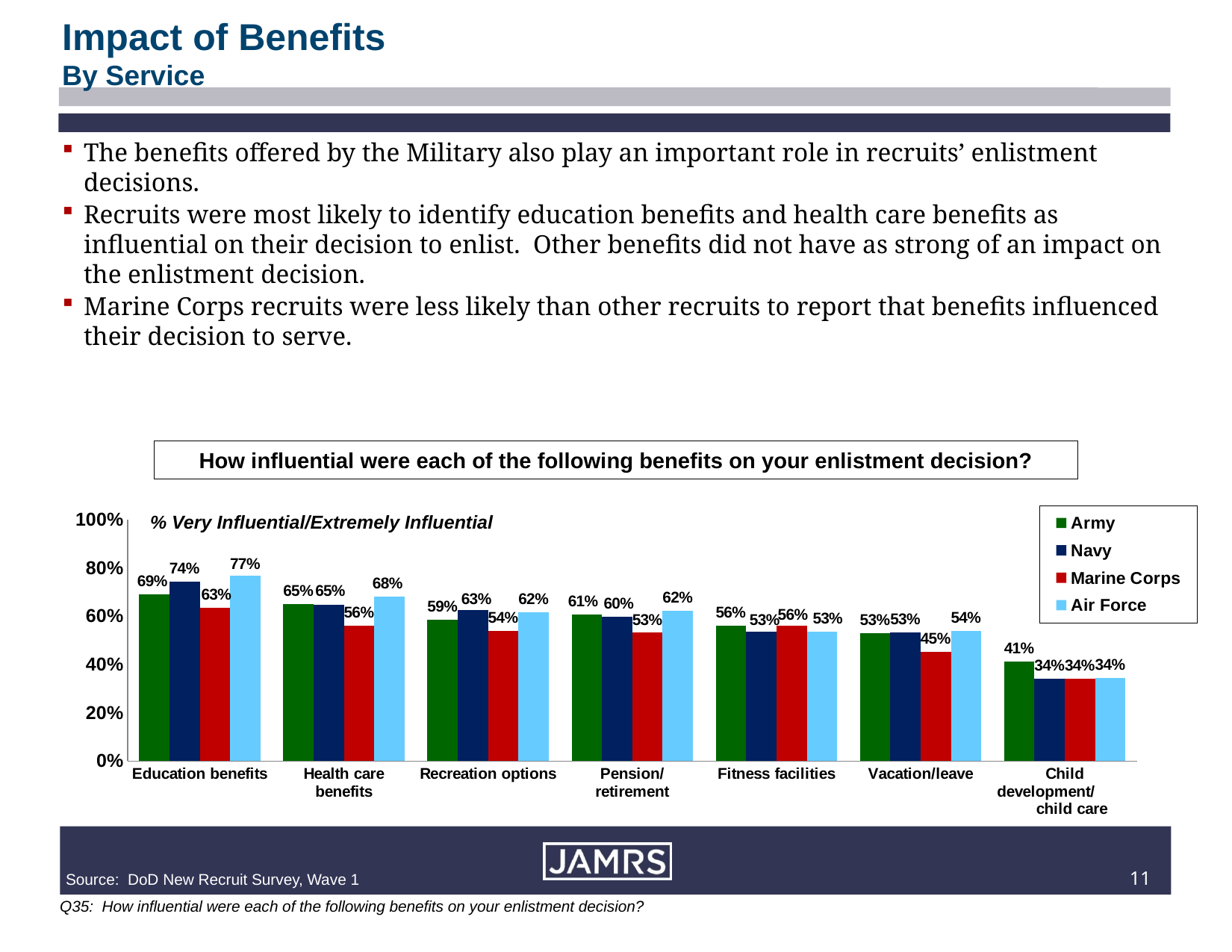
Which is larger for recreation options: the Navy value or the Army value? Navy How many benefit categories are shown on the x axis? 7 Which benefit category has the lowest Navy value? Child development/child care What percentage of Air Force recruits rated education benefits as very or extremely influential? 77% What is the difference between the Air Force and Marine Corps values for education benefits? 14 percentage points How many series does the legend list? 4 Which service has the lowest value for health care benefits? Marine Corps What colour represents the Marine Corps series in the chart? Red What kind of chart is shown on the slide? Bar chart What is the Marine Corps value for vacation/leave? 45% Which service has the highest value for education benefits? Air Force What is the Army value for child development/child care? 41%